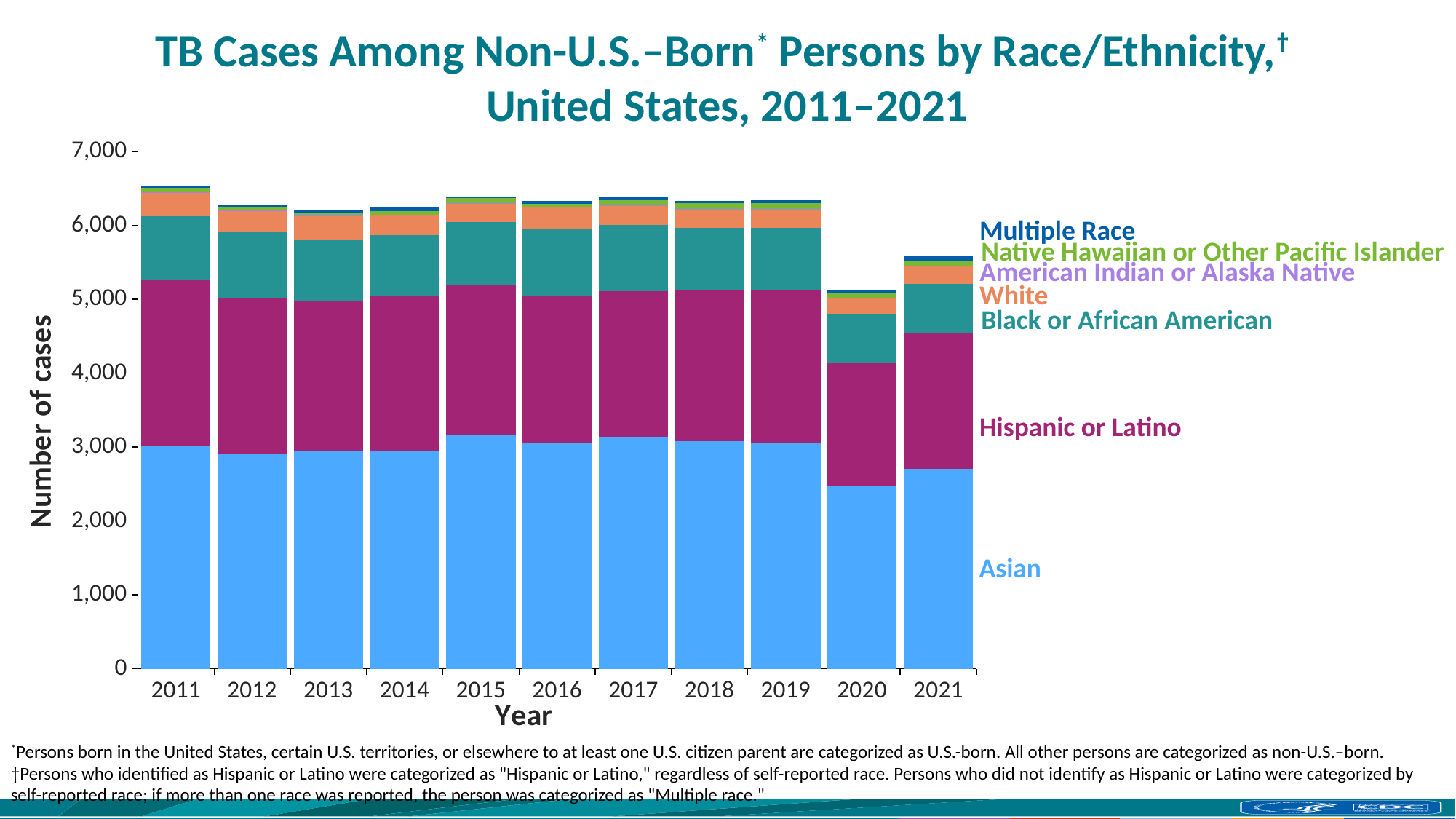
Is the Asian segment in 2020 greater or less than 3,000? less Which year has the larger total number of cases, 2020 or 2021? 2021 Which year has the highest total number of TB cases? 2011 What kind of chart is shown on the slide? Stacked bar chart Is the total number of cases in 2020 greater or less than 6,000? less Is the total number of cases in 2011 greater or less than 6,000? greater How many race/ethnicity series does the legend list? 7 Did the total number of cases rise or fall from 2019 to 2020? Fall Which year has the lowest total number of TB cases? 2020 Which race/ethnicity group forms the bottom segment of each stacked bar? Asian Which series is listed at the top of the legend? Multiple Race How many years are shown along the x axis? 11